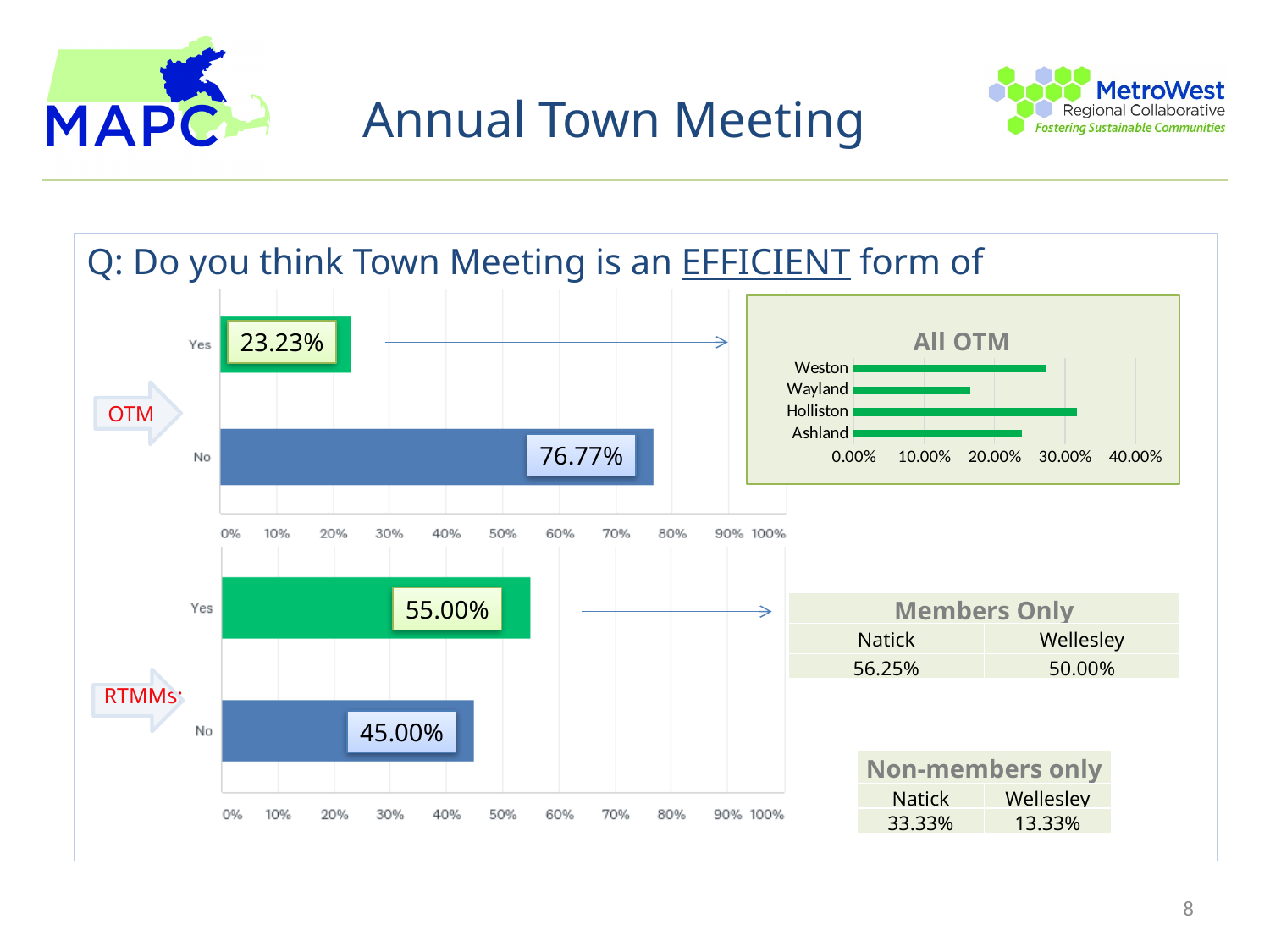
In the RTMMs chart, which response is larger, Yes or No? Yes In the OTM chart, what percentage answered No? 76.77% In the All OTM chart, which town has the lowest value? Wayland In the OTM chart, what percentage answered Yes? 23.23% In the OTM chart, which response has the lowest percentage? Yes In the OTM chart, what is the difference between the No and Yes percentages? 53.54% How many towns are shown in the All OTM chart? 4 In the RTMMs chart, what percentage answered No? 45.00% In the RTMMs chart, what percentage answered Yes? 55.00% In the All OTM chart, is the value for Wayland greater or less than 20.00%? less What kind of chart is the All OTM chart? bar chart In the All OTM chart, which town has the highest value? Holliston